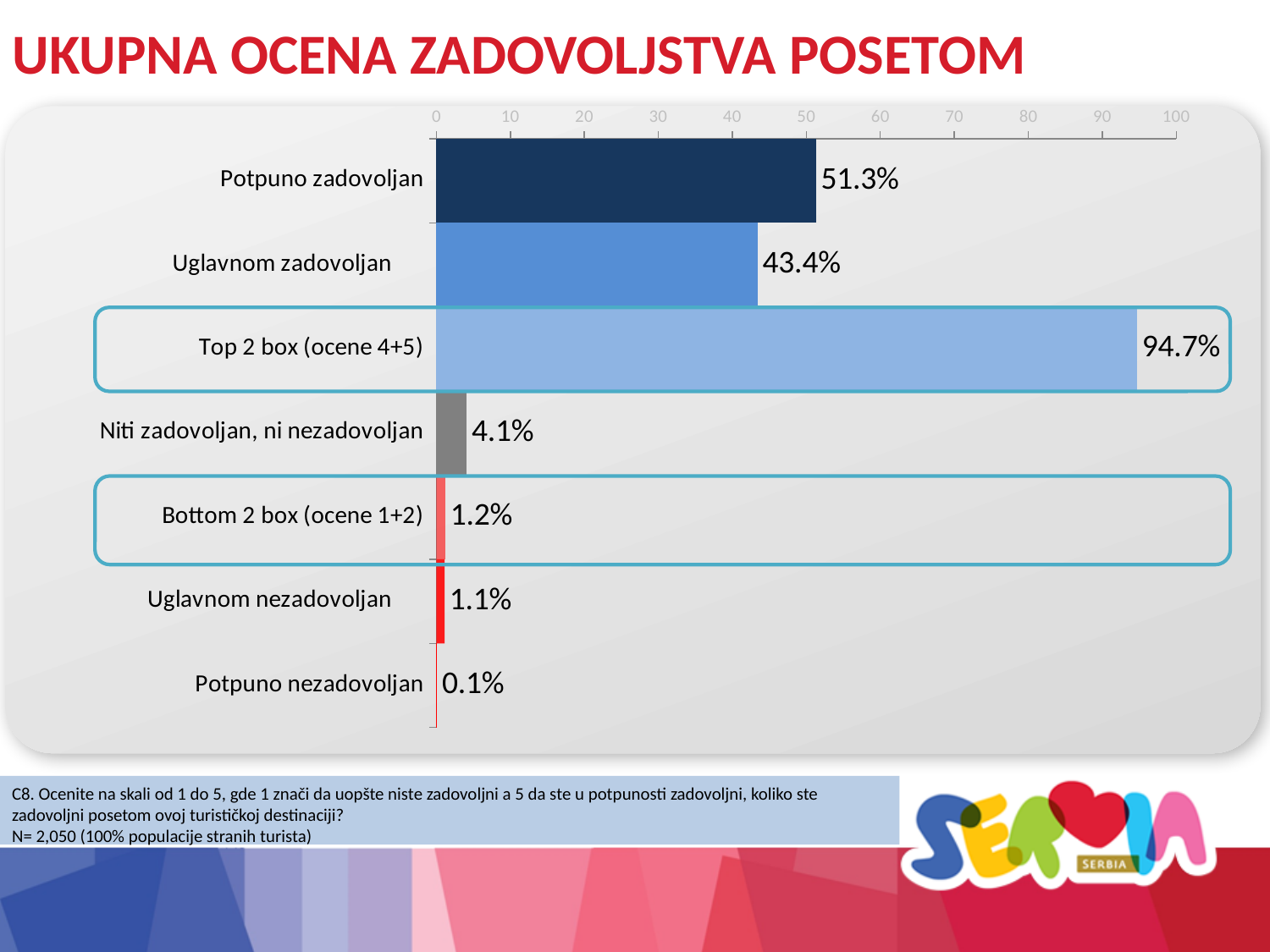
How many categories are shown in the chart? 7 What kind of chart is shown on the slide? Bar chart Which category has the highest value? Top 2 box (ocene 4+5) Which category has the lowest value? Potpuno nezadovoljan What is the difference between Potpuno zadovoljan and Uglavnom zadovoljan? 7.9% Which is larger, Uglavnom nezadovoljan or Potpuno nezadovoljan? Uglavnom nezadovoljan What is the value for Top 2 box (ocene 4+5)? 94.7% What is the value for Uglavnom zadovoljan? 43.4% What is the value for Niti zadovoljan, ni nezadovoljan? 4.1% Is the value for Potpuno zadovoljan greater or less than 50? greater What is the value for Potpuno zadovoljan? 51.3% What is the value for Bottom 2 box (ocene 1+2)? 1.2%